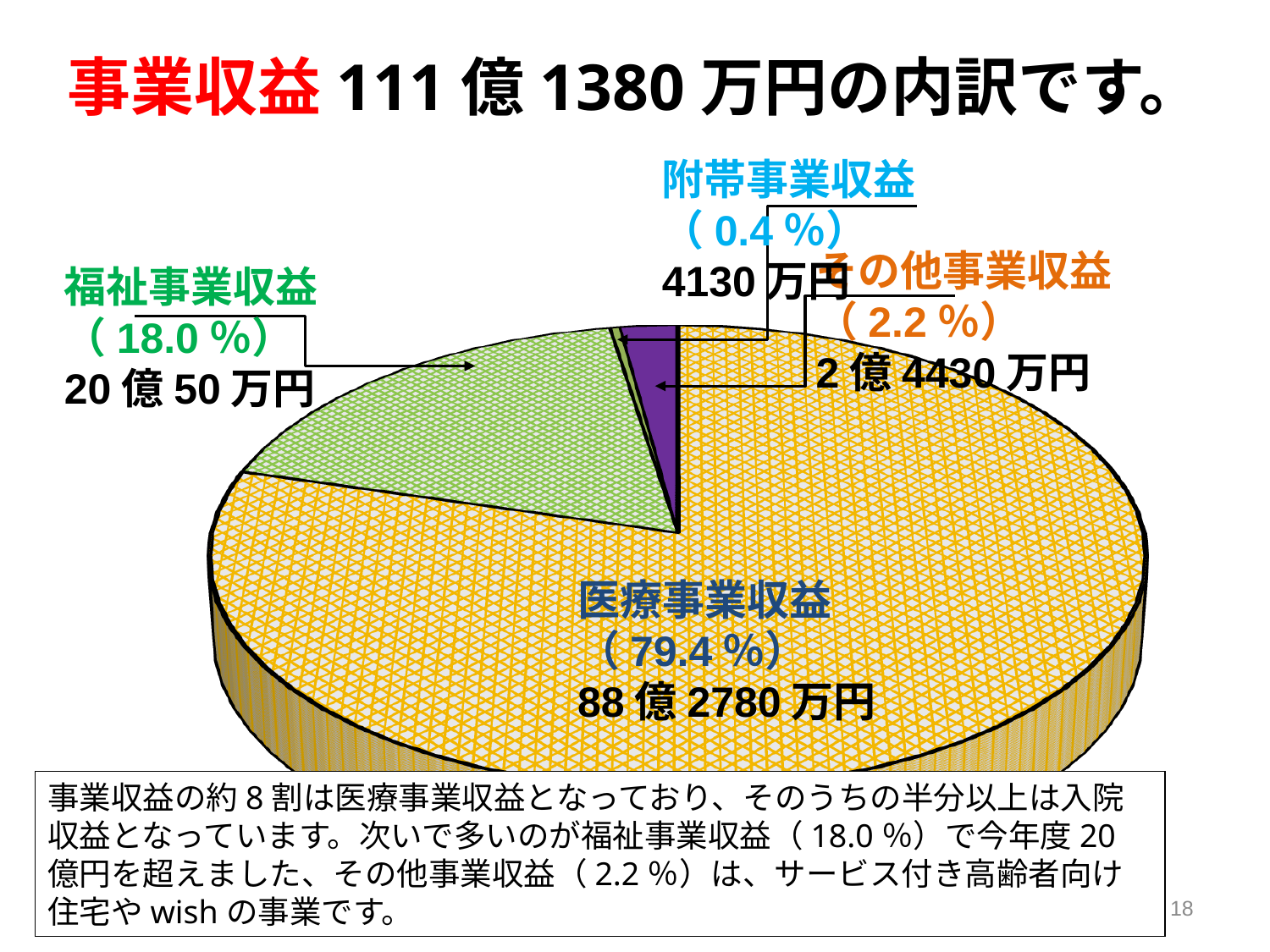
What share of the pie does 附帯事業収益 represent? 0.4% What share of the pie does 福祉事業収益 represent? 18.0% What is the value shown for 医療事業収益? 88億2780万円 What share of the pie does その他事業収益 represent? 2.2% Which category has the largest slice of the pie? 医療事業収益 Which category has the smallest slice of the pie? 附帯事業収益 Which is larger, the share for 福祉事業収益 or the share for その他事業収益? 福祉事業収益 What is the value shown for その他事業収益? 2億4430万円 What kind of chart is shown on the slide? Pie chart How many slices does the pie chart have? 4 What is the value shown for 福祉事業収益? 20億50万円